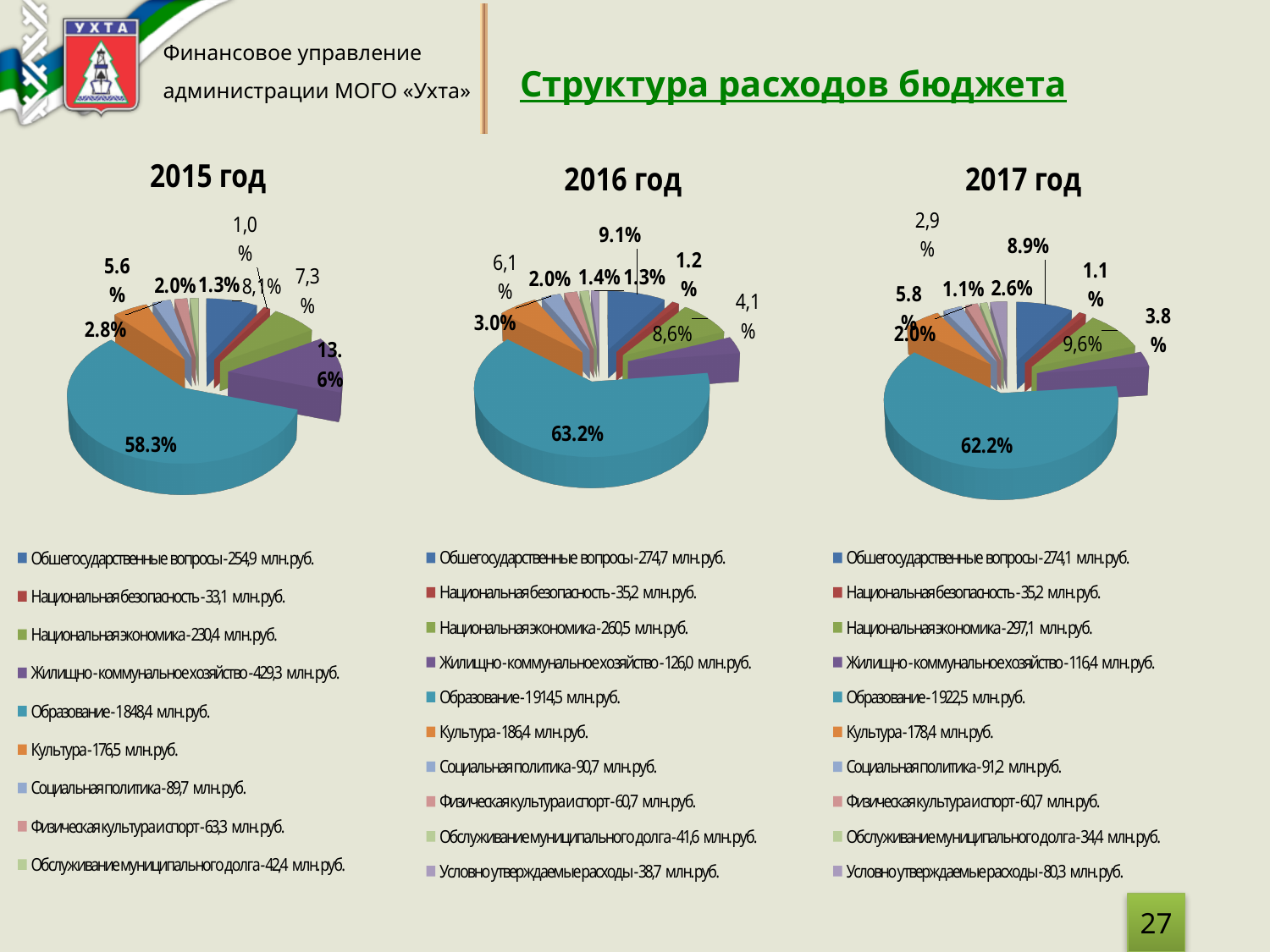
What is the title of the slide above the three charts? Структура расходов бюджета In the 2016 год chart, what share of the pie does the largest slice (Образование) have? 63.2% In the 2015 год chart, which category has the largest slice? Образование How many categories does the legend of the 2015 год chart list? 9 In the 2015 год chart, what share of the pie does the largest slice (Образование) have? 58.3% How many categories does the legend of the 2017 год chart list? 10 In the 2017 год chart, what share of the pie does the largest slice (Образование) have? 62.2% According to the legend of the 2016 год chart, what is the value for Образование? 1914,5 млн.руб. What kind of chart is used for the 2015 год chart? pie chart Which is larger: the Образование share in the 2016 год chart or in the 2017 год chart? 2016 год According to the legend of the 2017 год chart, what is the value for Национальная экономика? 297,1 млн.руб. According to the legend of the 2015 год chart, what is the value for Жилищно-коммунальное хозяйство? 429,3 млн.руб.